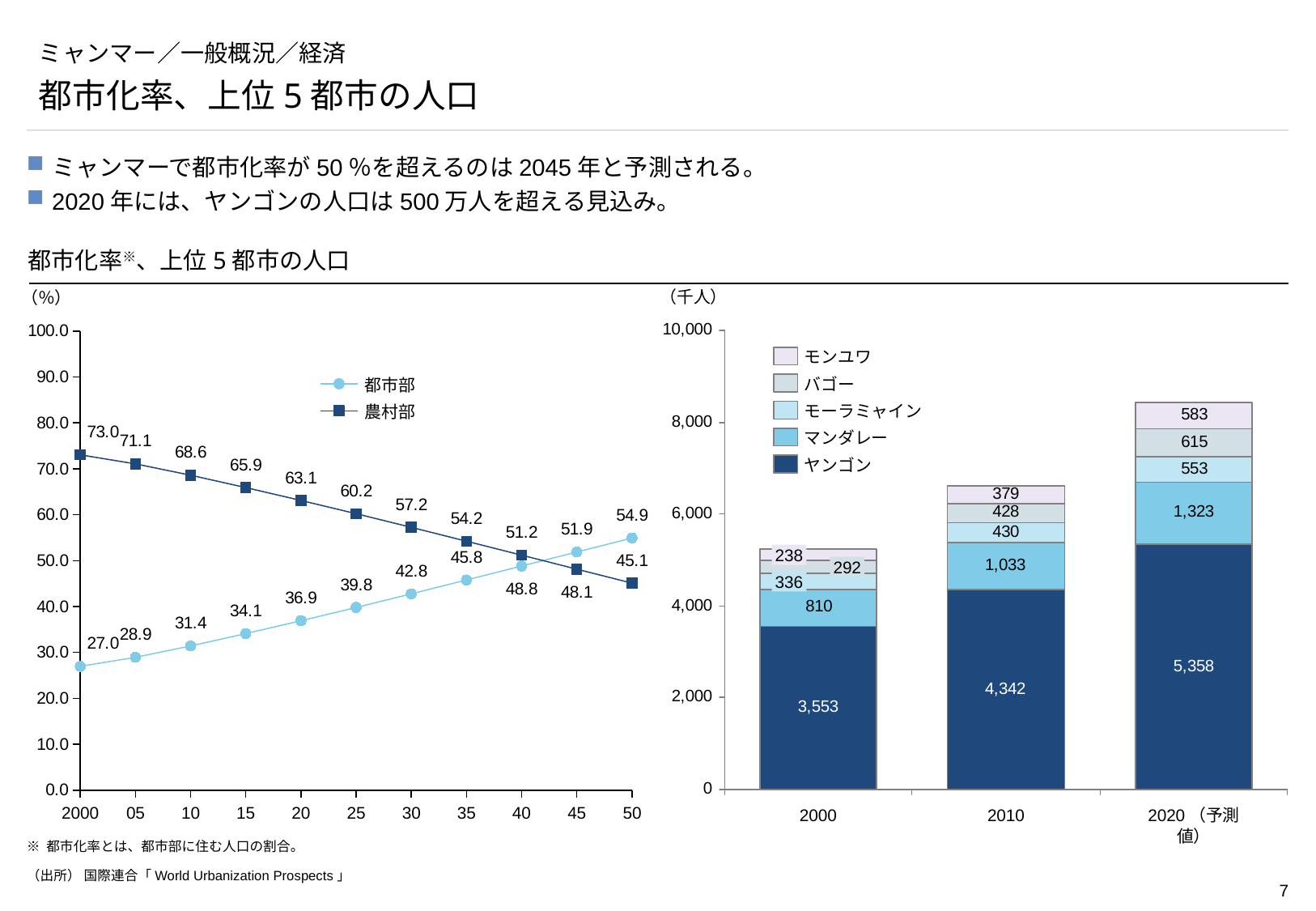
In the line chart on the left, what is the value for 農村部 in 2050? 45.1 In the line chart on the left, which series has the larger value in 2045, 都市部 or 農村部? 都市部 In the stacked bar chart on the right, what is the difference between ヤンゴン in 2020 and ヤンゴン in 2000? 1,805 In the line chart on the left, does the 都市部 series rise or fall from 2000 to 2050? rise In the line chart on the left, what is the value for 都市部 in 2000? 27.0 In the stacked bar chart on the right, what is the value for ヤンゴン in 2020? 5,358 How many series does the legend of the line chart on the left list? 2 In the stacked bar chart on the right, what is the value for マンダレー in 2010? 1,033 In the line chart on the left, what is the difference between 農村部 and 都市部 in 2000? 46.0 How many series does the legend of the stacked bar chart on the right list? 5 In the stacked bar chart on the right, what is the total of the 2010 bar? 6,612 What kind of chart is the chart on the right of the slide? stacked bar chart